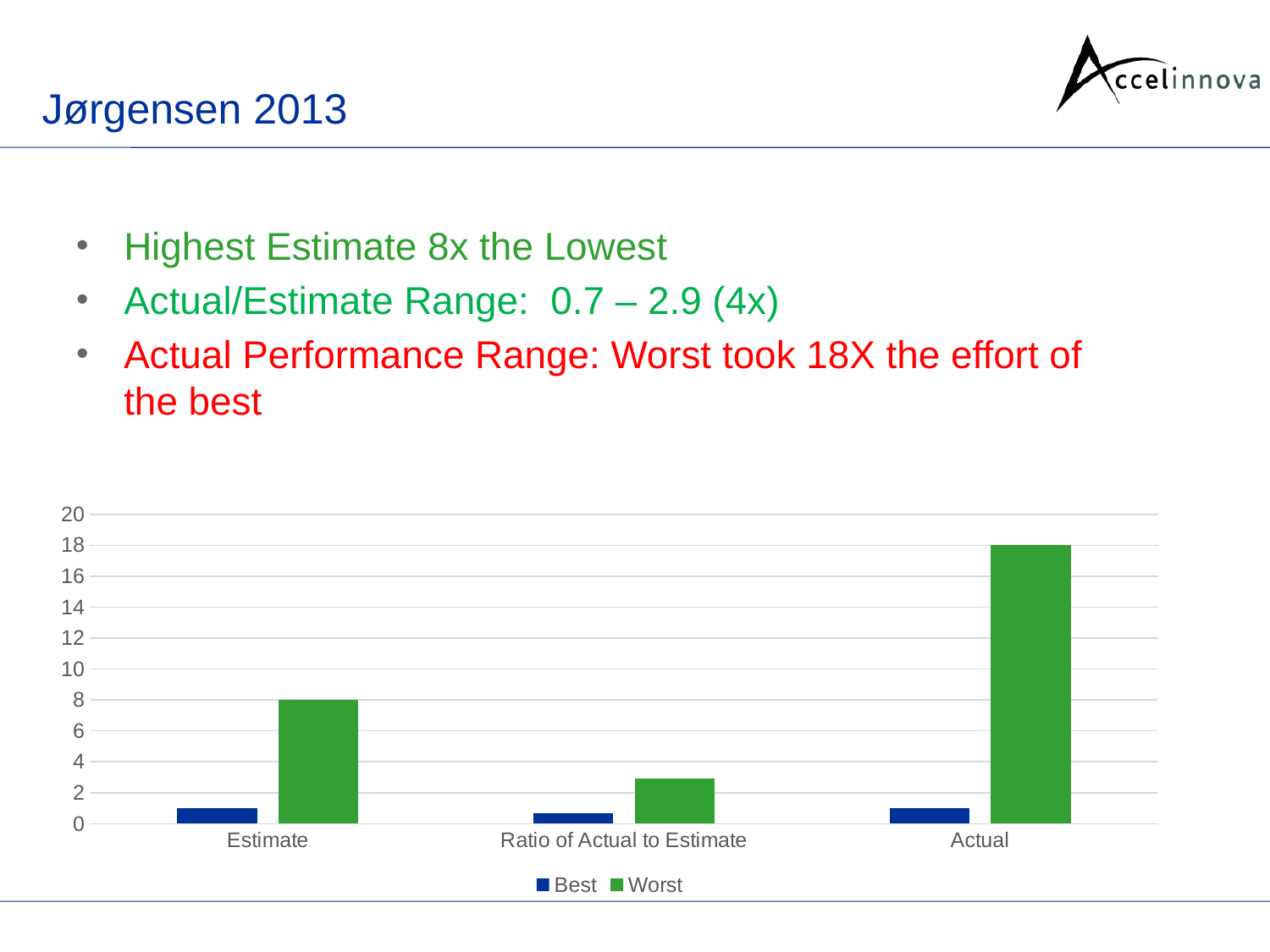
Is the Best value for Estimate greater or less than 2? less Which is larger, the Worst value for Actual or the Worst value for Estimate? Actual How many categories are shown on the x axis of the chart? 3 Which category has the lowest Worst value? Ratio of Actual to Estimate What is the Worst value for Estimate? 8 How many series does the chart legend list? 2 Which category has the highest Worst value? Actual Is the Worst value for Ratio of Actual to Estimate greater or less than 4? less What are the two entries in the chart legend? Best and Worst What is the Worst value for Actual? 18 What kind of chart is shown on the slide? bar chart What is the difference between the Worst value for Actual and the Worst value for Estimate? 10